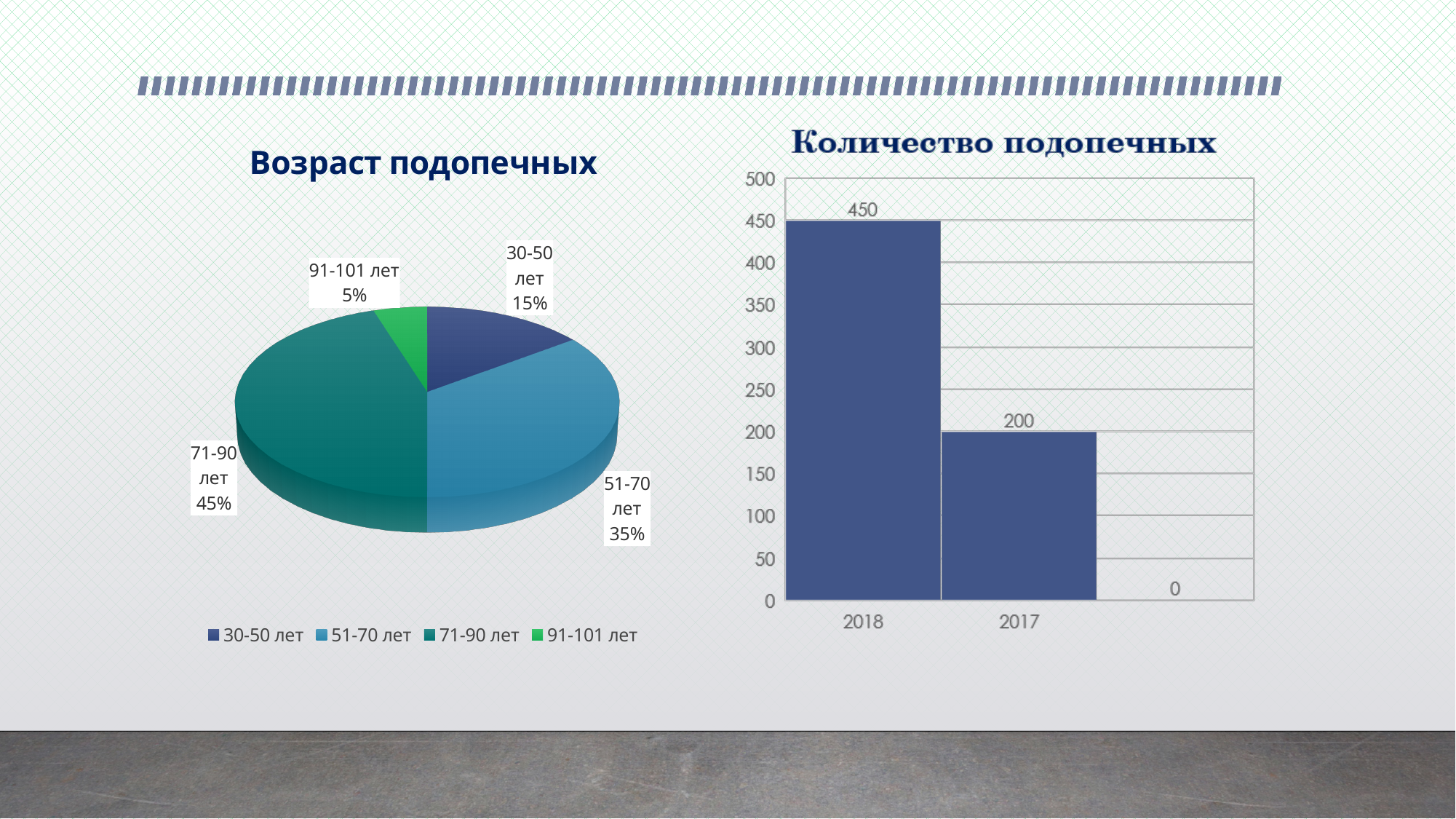
In the pie chart "Возраст подопечных", which age group has the largest share? 71-90 лет In the pie chart "Возраст подопечных", what share is shown for 71-90 лет? 45% In the chart "Количество подопечных", what is the difference between the values for 2018 and 2017? 250 What type of chart is "Количество подопечных"? bar chart What type of chart is "Возраст подопечных"? pie chart In the pie chart "Возраст подопечных", which age group has the smallest share? 91-101 лет In the pie chart "Возраст подопечных", which is larger: the share for 51-70 лет or for 30-50 лет? 51-70 лет In the chart "Количество подопечных", what is the value for 2018? 450 In the pie chart "Возраст подопечных", how many age groups are shown? 4 In the pie chart "Возраст подопечных", what is the difference in percentage points between 51-70 лет and 91-101 лет? 30 In the pie chart "Возраст подопечных", what share is shown for 30-50 лет? 15% In the chart "Количество подопечных", what is the value for 2017? 200